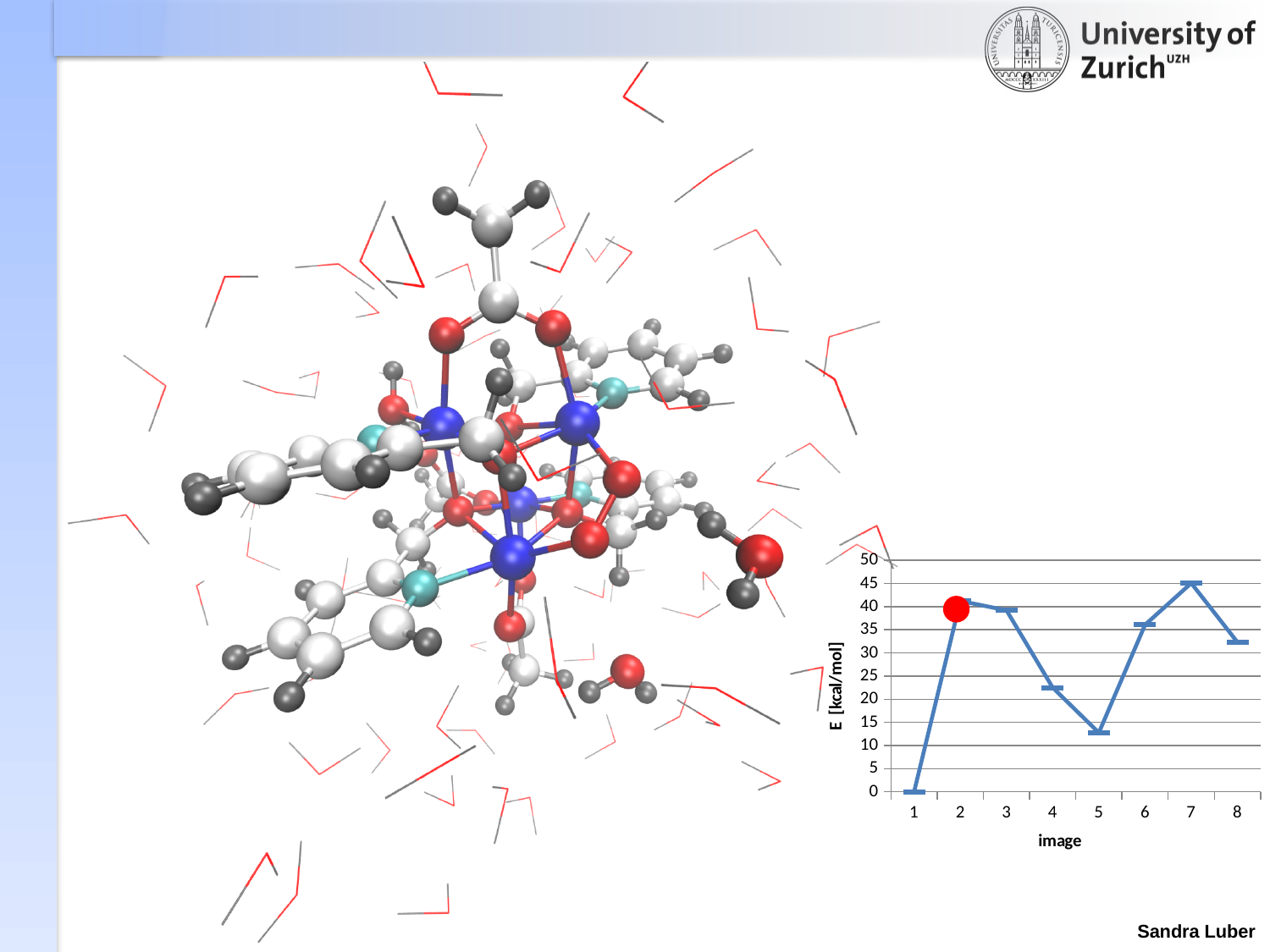
What kind of chart is shown on the slide? line chart What is the energy value for image 1? 0 Is the value for image 4 greater or less than 30? less What is the label of the y axis of the chart? E [kcal/mol] Is the value for image 6 greater or less than 30? greater Which image has the highest energy in the chart? 7 Is the value for image 8 greater or less than 40? less Which image has the lowest energy in the chart? 1 What is the energy value for image 7? 45 Which has the larger energy value, image 2 or image 5? image 2 How many images (data points) are plotted along the x axis of the chart? 8